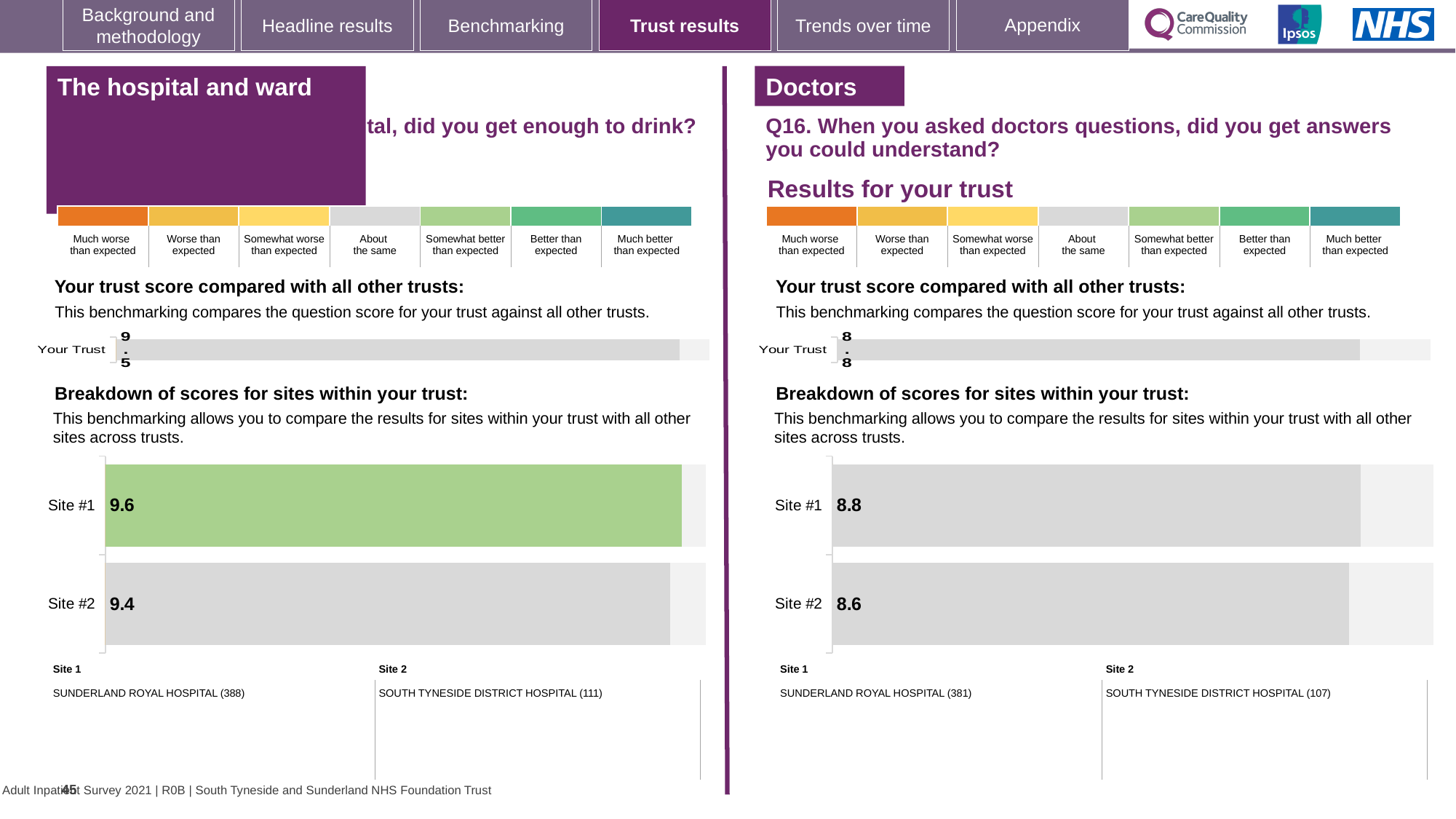
On the left-hand site breakdown chart, which site has the higher score? Site #1 On the Q16 'Breakdown of scores for sites within your trust' chart, what is the score for Site #1? 8.8 On the Q16 'Your trust score compared with all other trusts' chart, what is the score shown for Your Trust? 8.8 On the left-hand site breakdown chart, what is the difference between the Site #1 and Site #2 scores? 0.2 On the left-hand site breakdown chart, what colour is the bar for Site #1? Green What type of chart is used for the Q16 site breakdown? Bar chart On the left-hand 'Your trust score compared with all other trusts' chart, what is the score shown for Your Trust? 9.5 On the left-hand 'Breakdown of scores for sites within your trust' chart, what is the score for Site #1? 9.6 On the Q16 site breakdown chart, which site has the lower score? Site #2 On the left-hand 'Breakdown of scores for sites within your trust' chart, what is the score for Site #2? 9.4 On the Q16 'Breakdown of scores for sites within your trust' chart, what is the score for Site #2? 8.6 On the Q16 site breakdown chart, how many sites are shown? 2